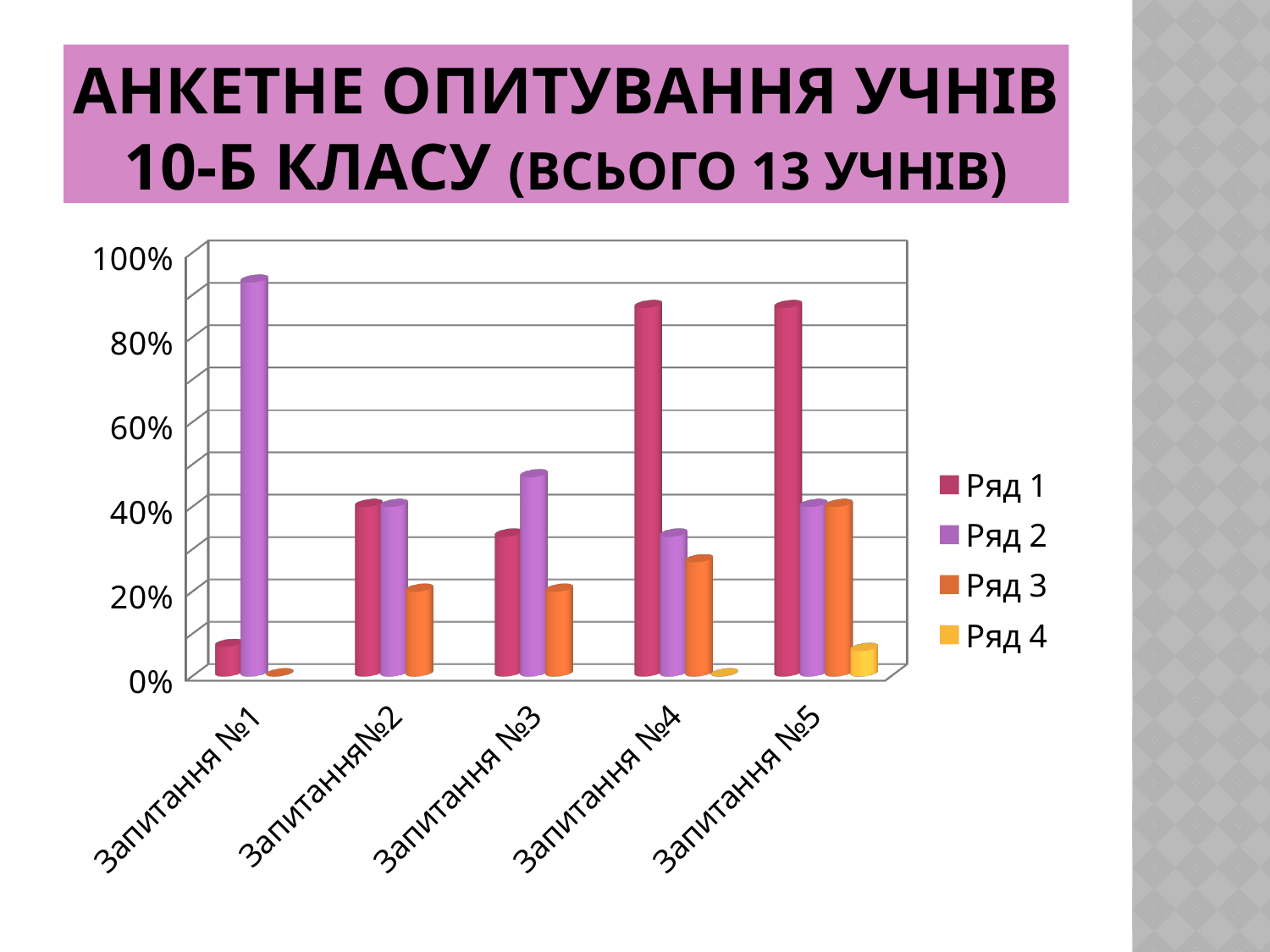
Is the value of Ряд 4 for Запитання №5 greater or less than 20%? less Is the value of Ряд 1 for Запитання №4 greater or less than 80%? greater How many question categories are shown on the x axis? 5 For Запитання №5, which series has the lowest value? Ряд 4 What are the legend entries of the chart? Ряд 1, Ряд 2, Ряд 3, Ряд 4 For Запитання №1, which series has the highest value? Ряд 2 For Запитання №4, which is larger: Ряд 1 or Ряд 2? Ряд 1 For Запитання №3, which is larger: Ряд 1 or Ряд 2? Ряд 2 Is the value of Ряд 2 for Запитання №1 greater or less than 80%? greater What kind of chart is shown on the slide? bar chart How many series does the legend list? 4